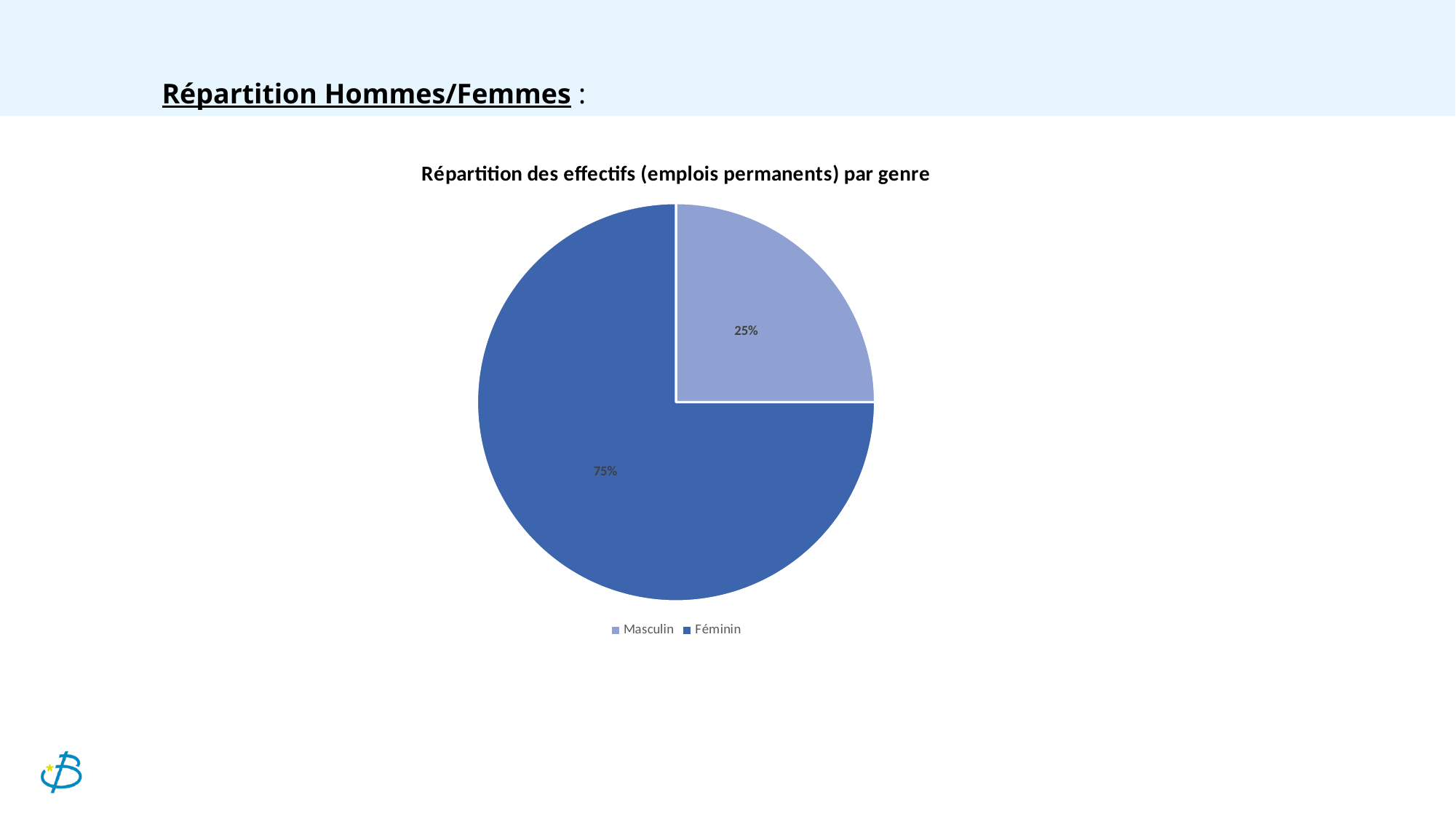
What type of chart is shown on the slide? pie chart What share of the pie does Féminin represent? 75% How many categories does the pie chart show? 2 What share of the pie does Masculin represent? 25% Which is larger, the Masculin share or the Féminin share? Féminin What is the title of the chart? Répartition des effectifs (emplois permanents) par genre Which legend entry is shown in the lighter blue colour? Masculin What is the difference in percentage points between the Féminin and Masculin shares? 50 How many entries does the legend list? 2 Which category has the largest share of the pie? Féminin Is the share for Féminin greater or less than 50%? greater Which category has the smallest share of the pie? Masculin